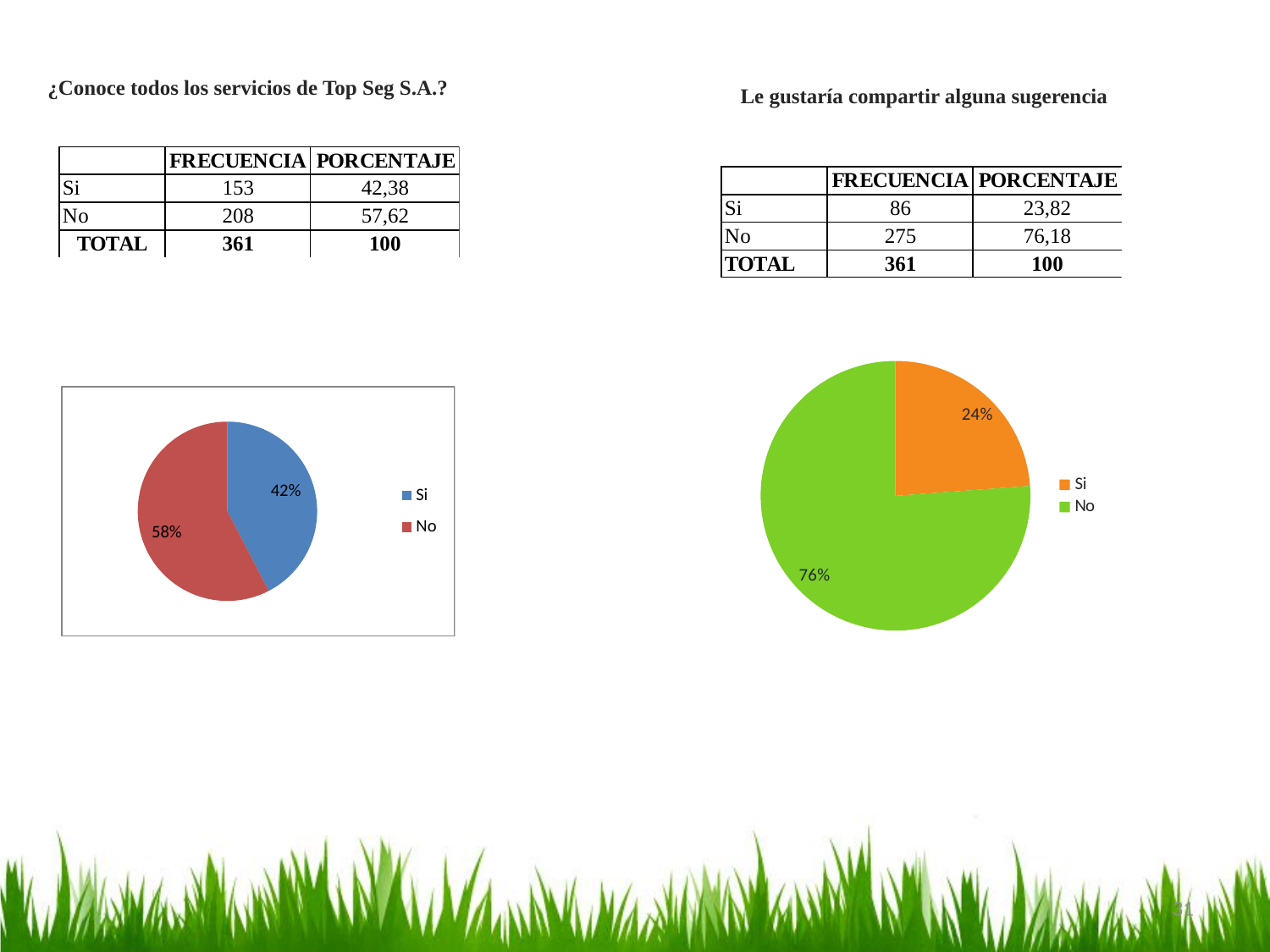
In the left pie chart, what is the difference in percentage points between No and Si? 16 In the left pie chart, which category has the largest slice? No In the right pie chart, which category has the smallest slice? Si What type of chart is shown on the right side of the slide? Pie chart In the left pie chart, which is larger, Si or No? No In the left pie chart, what colour is the slice for Si? Blue In the left pie chart (¿Conoce todos los servicios de Top Seg S.A.?), what percentage is shown for Si? 42% In the right pie chart, what is the difference in percentage points between No and Si? 52 In the left pie chart (¿Conoce todos los servicios de Top Seg S.A.?), what percentage is shown for No? 58% In the right pie chart (Le gustaría compartir alguna sugerencia), what percentage is shown for No? 76% In the right pie chart (Le gustaría compartir alguna sugerencia), what percentage is shown for Si? 24% How many categories does the legend of the right pie chart list? 2